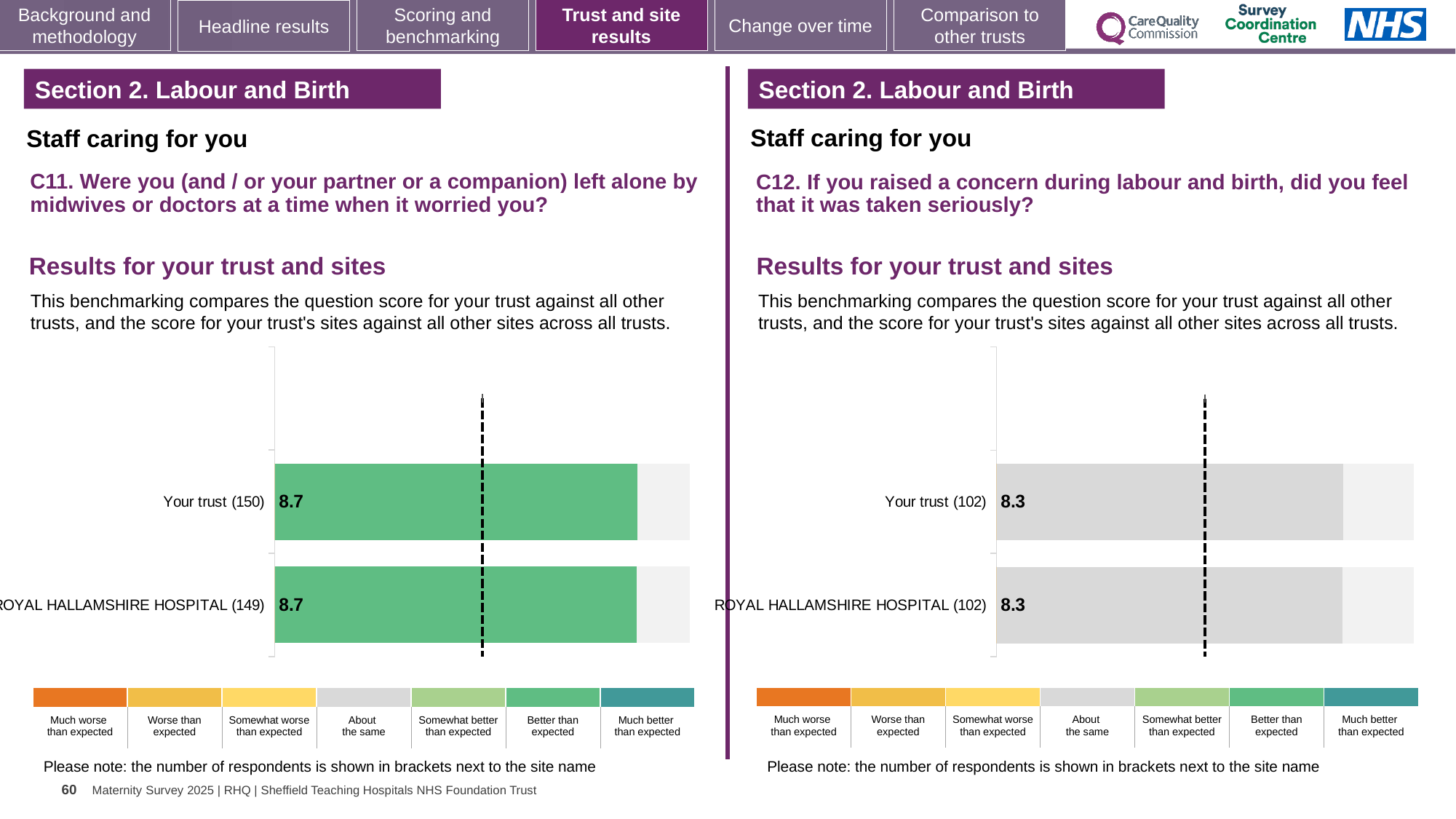
On the C12 chart (right), how many respondents are shown in brackets for ROYAL HALLAMSHIRE HOSPITAL? 102 What type of chart is used on the C11 chart (left)? Bar chart On the C12 chart (right), what is the score for Your trust? 8.3 On the C11 chart (left), what is the score for Your trust? 8.7 On the C12 chart (right), which benchmark category does the grey colour of the bars correspond to in the legend? About the same On the C11 chart (left), what is the difference between the Your trust score and the ROYAL HALLAMSHIRE HOSPITAL score? 0 On the C12 chart (right), what is the difference between the Your trust score and the ROYAL HALLAMSHIRE HOSPITAL score? 0 On the C12 chart (right), what is the score for ROYAL HALLAMSHIRE HOSPITAL? 8.3 On the C11 chart (left), how many respondents are shown in brackets for Your trust? 150 How many bars are plotted on the C12 chart (right)? 2 How many bars are plotted on the C11 chart (left)? 2 On the C11 chart (left), what is the score for ROYAL HALLAMSHIRE HOSPITAL? 8.7